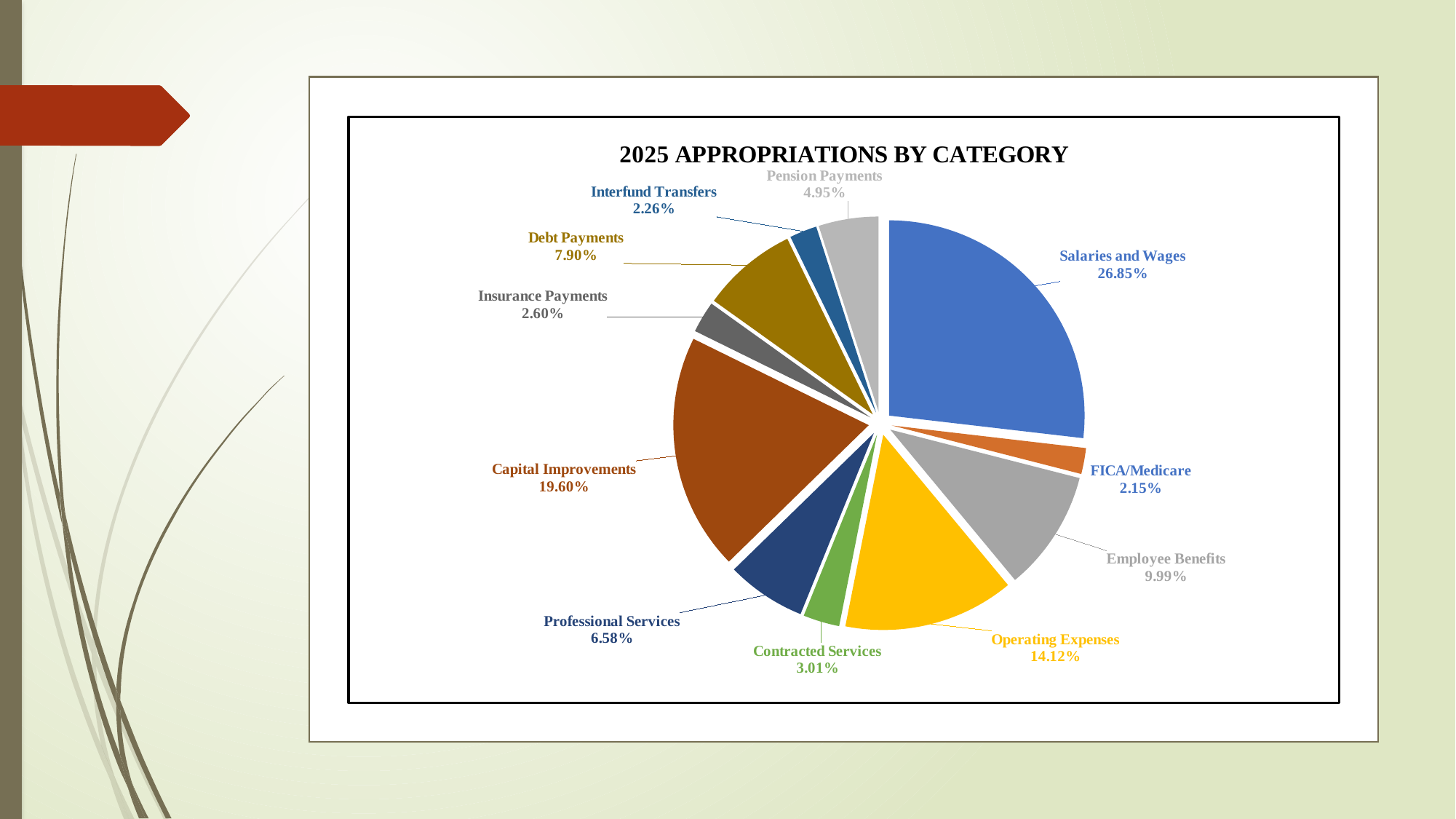
Which category has the largest share of the pie? Salaries and Wages Which category has the smallest share of the pie? FICA/Medicare What is the difference between the Operating Expenses share and the Debt Payments share? 6.22% What percentage is shown for Contracted Services? 3.01% What kind of chart is shown on the slide? Pie chart What percentage is shown for Capital Improvements? 19.60% What share of the pie is Salaries and Wages? 26.85% What is the difference between the Salaries and Wages share and the Capital Improvements share? 7.25% Which is larger, Professional Services or Pension Payments? Professional Services What percentage is shown for Employee Benefits? 9.99% What is the title of the chart? 2025 APPROPRIATIONS BY CATEGORY How many categories are shown in the pie chart? 11